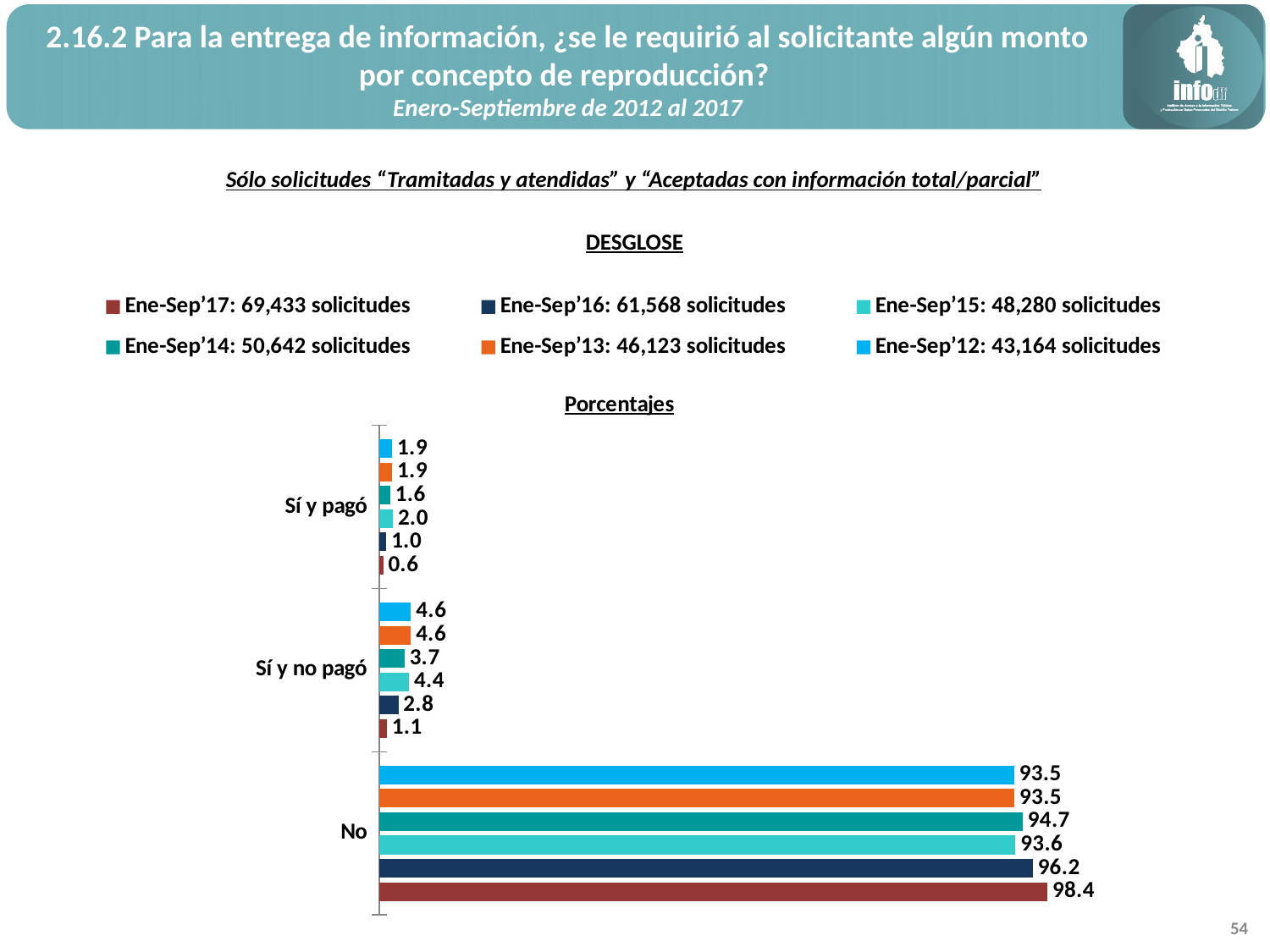
What is the value for "Sí y pagó" in the Ene-Sep'15 series? 2.0 What is the difference between the Ene-Sep'17 and Ene-Sep'12 values for "No"? 4.9 Which is larger for "Sí y no pagó": the Ene-Sep'15 value or the Ene-Sep'16 value? Ene-Sep'15 How many categories are shown on the chart? 3 What is the value for "No" in the Ene-Sep'17 series? 98.4 Which series has the highest value for "No"? Ene-Sep'17 According to the legend, how many solicitudes does the Ene-Sep'16 series represent? 61,568 solicitudes Which series has the lowest value for "Sí y no pagó"? Ene-Sep'17 How many series does the legend list? 6 What type of chart is shown on the slide? Bar chart What is the value for "Sí y no pagó" in the Ene-Sep'14 series? 3.7 Across the series from Ene-Sep'12 to Ene-Sep'17, does the value for "Sí y no pagó" generally rise or fall? Fall